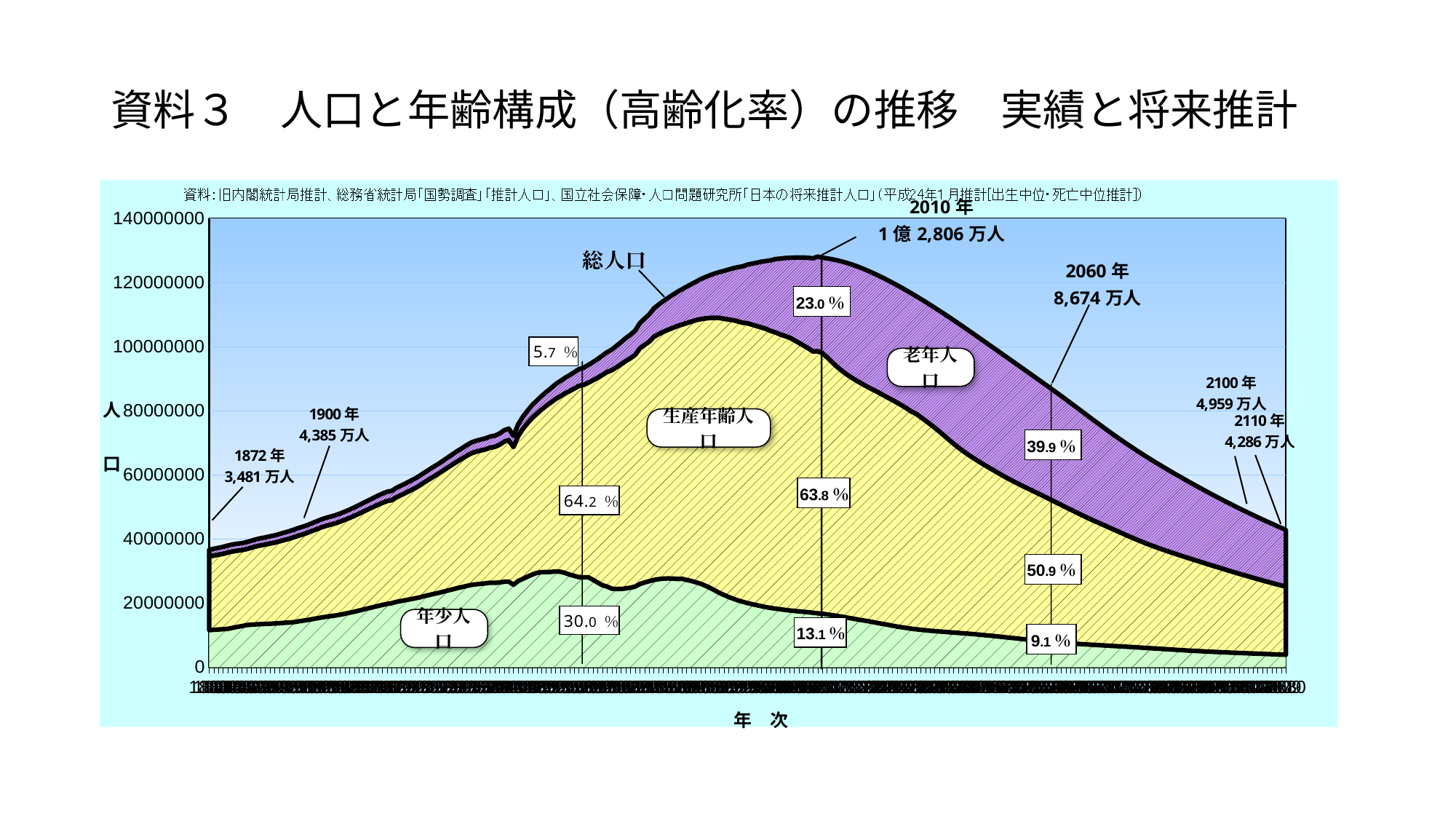
By how much does the total population fall from 2100 (4,959万人) to 2110 (4,286万人)? 673万人 What is the total population shown for 2110 (2110年)? 4,286万人 How many age-group areas are stacked in the chart? 3 What is the total population shown for 2010 (2010年)? 1億2,806万人 Which year has the larger total population, 2010 or 2060? 2010 What is the total population shown for 2060 (2060年)? 8,674万人 What kind of chart is shown on the slide? Stacked area chart What share of the population is 生産年齢人口 (working-age) in 2010? 63.8% What share of the population is 老年人口 (elderly) in 2060? 39.9% Does the total population rise or fall along the x axis after 2010? Fall What is the total population shown for 1872 (1872年)? 3,481万人 What share of the population is 年少人口 (young) in 2060? 9.1%